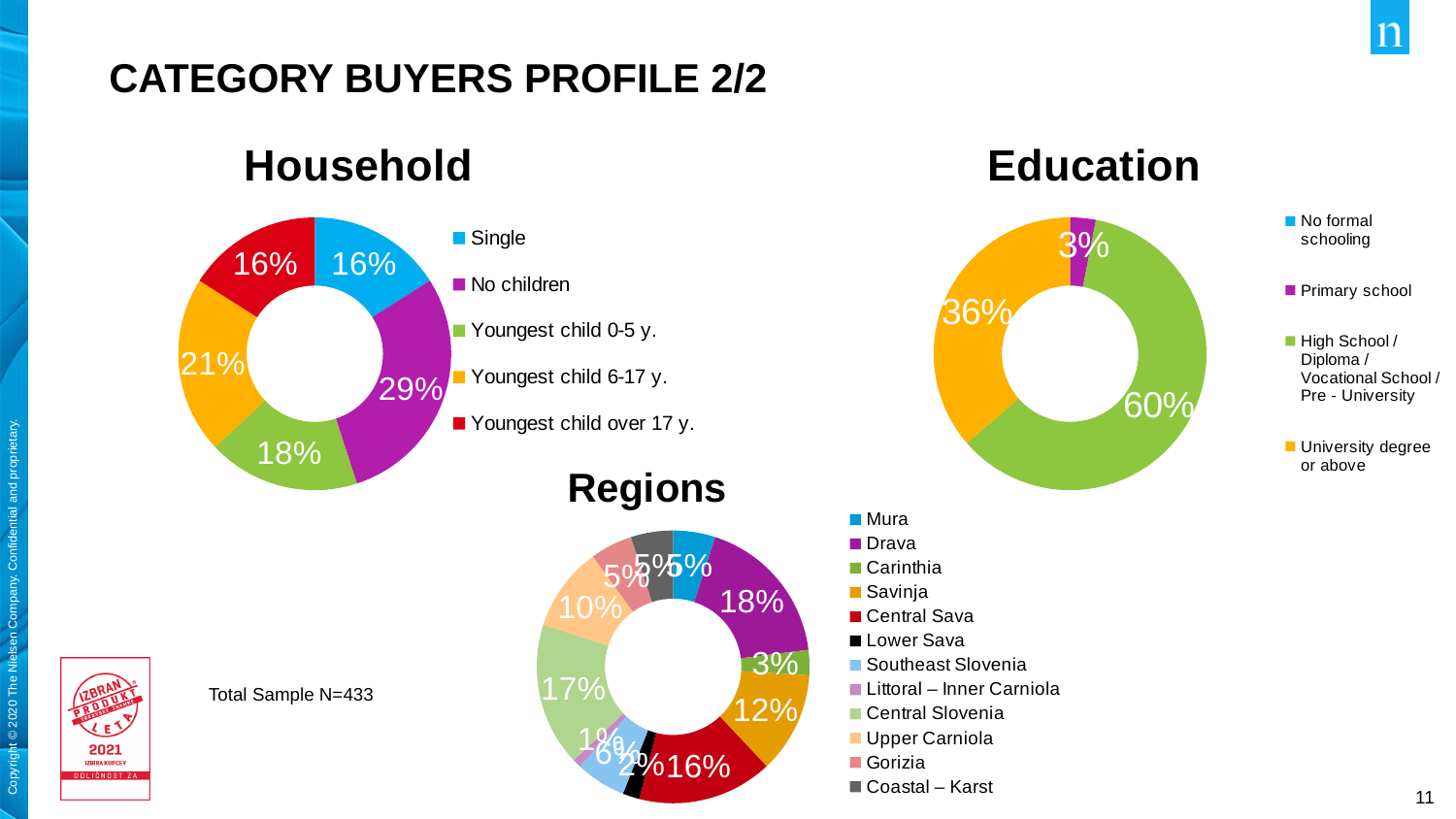
In the Education chart, what percentage is shown for High School / Diploma / Vocational School / Pre - University? 60% In the Household chart, which category has the largest share? No children How many regions does the legend of the Regions chart list? 12 In the Education chart, what is the difference in percentage points between High School and University degree or above? 24 percentage points In the Regions chart, what percentage is shown for Drava? 18% In the Education chart, what percentage is shown for Primary school? 3% What kind of chart is the Household chart? Donut chart In the Household chart, what percentage is shown for No children? 29% In the Household chart, what percentage is shown for Youngest child 6-17 y.? 21% How many entries does the legend of the Education chart list? 4 In the Household chart, which is larger: Single or Youngest child 0-5 y.? Youngest child 0-5 y. In the Household chart, what is the difference in percentage points between No children and Youngest child 0-5 y.? 11 percentage points